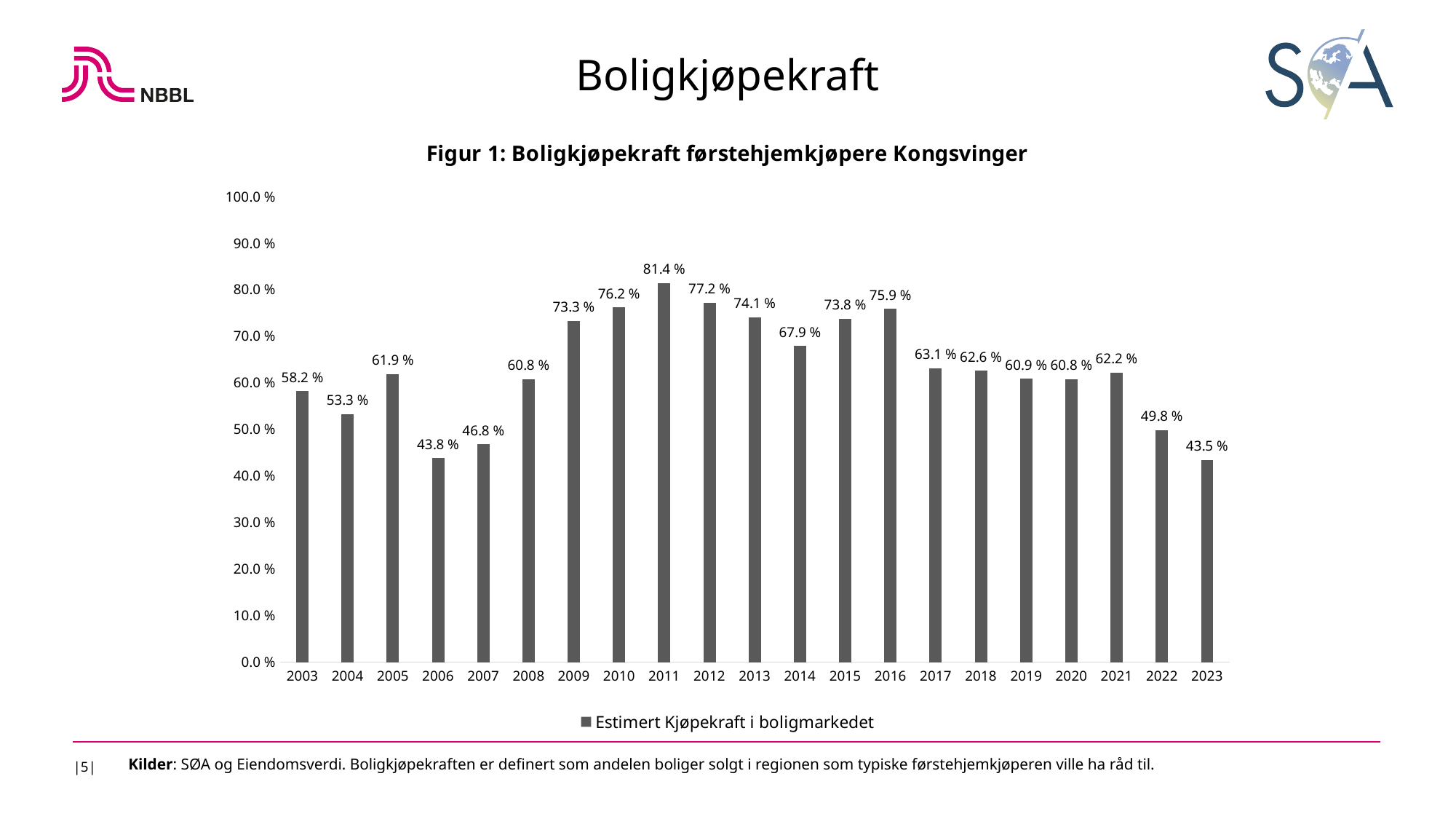
Is the value for 2014 greater or less than 70.0 %? less Which year has the highest value? 2011 Which is larger, the value for 2010 or the value for 2012? 2012 What is the value for 2006? 43.8 % What is the difference between the values for 2011 and 2023? 37.9 % Which year has the lowest value? 2023 How many years are shown on the x axis? 21 What is the value for 2011? 81.4 % How many series does the legend list? 1 What kind of chart is shown? bar chart What is the value for 2023? 43.5 % What is the title of the chart? Figur 1: Boligkjøpekraft førstehjemkjøpere Kongsvinger